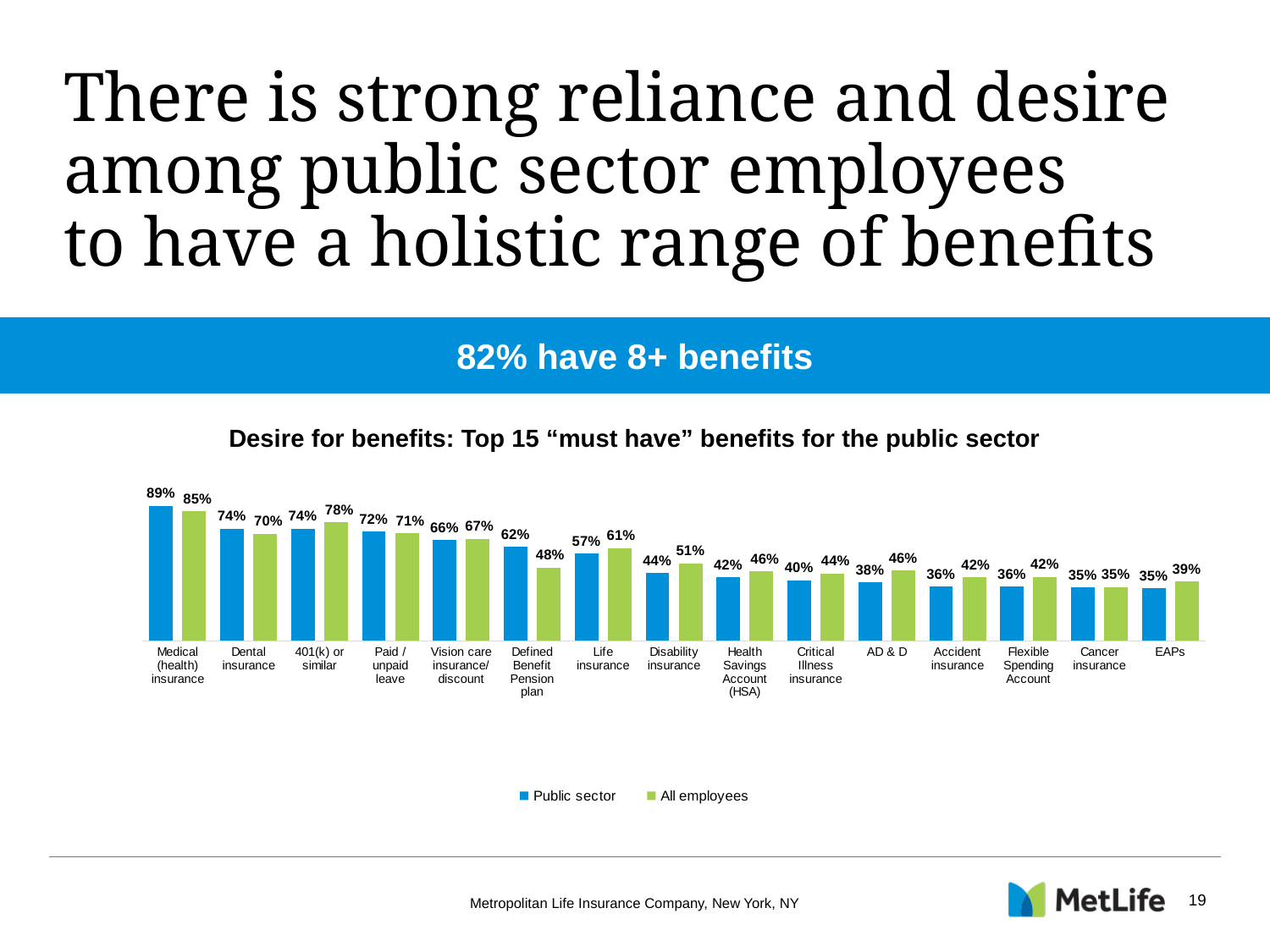
What is the Public sector value for Life insurance? 57% What kind of chart is shown on the slide? Bar chart What is the difference between the Public sector and All employees values for Defined Benefit Pension plan? 14% What is the Public sector value for Medical (health) insurance? 89% What is the title of the chart? Desire for benefits: Top 15 "must have" benefits for the public sector How many categories are shown on the x axis? 15 How many series does the legend list? 2 Which category has the lowest All employees value? Cancer insurance Which is larger for Dental insurance: the Public sector value or the All employees value? Public sector Which category has the highest Public sector value? Medical (health) insurance Do the Public sector values generally rise or fall from left to right along the x axis? Fall What is the All employees value for Defined Benefit Pension plan? 48%